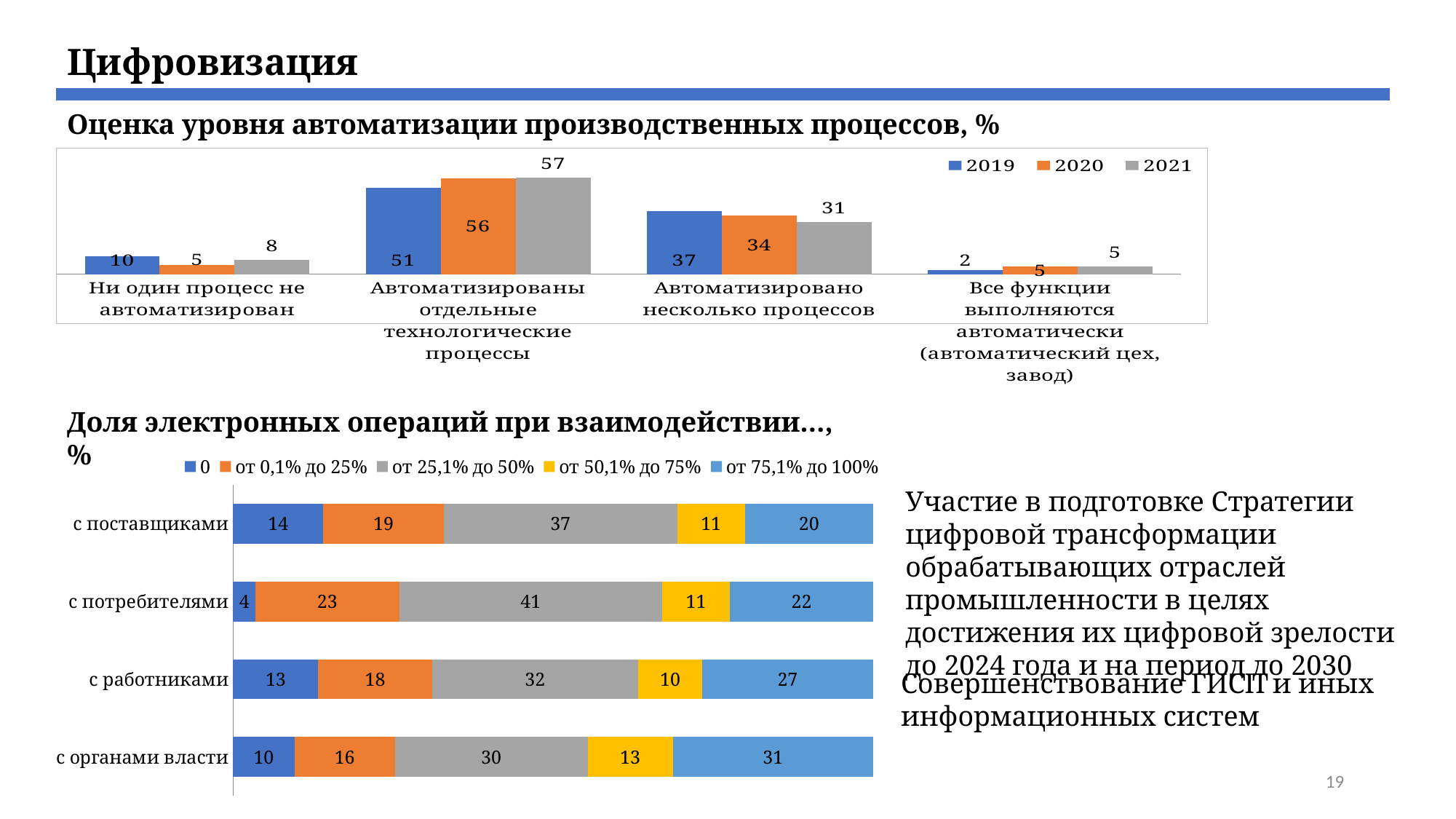
In the top chart 'Оценка уровня автоматизации производственных процессов, %', what is the difference between the 2019 and 2021 values for 'Автоматизировано несколько процессов'? 6 In the top chart 'Оценка уровня автоматизации производственных процессов, %', how many series does the legend list? 3 In the bottom chart 'Доля электронных операций при взаимодействии..., %', what is the value of the 'от 25,1% до 50%' segment for 'с потребителями'? 41 What type of chart is the bottom chart 'Доля электронных операций при взаимодействии..., %'? stacked bar chart In the top chart 'Оценка уровня автоматизации производственных процессов, %', which category has the lowest value in 2019? Все функции выполняются автоматически (автоматический цех, завод) In the top chart 'Оценка уровня автоматизации производственных процессов, %', what is the 2019 value for 'Автоматизировано несколько процессов'? 37 In the top chart 'Оценка уровня автоматизации производственных процессов, %', do the values for 'Автоматизировано несколько процессов' rise or fall from 2019 to 2021? fall In the top chart 'Оценка уровня автоматизации производственных процессов, %', which category has the highest value in 2020? Автоматизированы отдельные технологические процессы In the bottom chart 'Доля электронных операций при взаимодействии..., %', which is larger: the '0' segment for 'с поставщиками' or for 'с потребителями'? с поставщиками In the bottom chart 'Доля электронных операций при взаимодействии..., %', what is the total of the stacked bar for 'с работниками'? 100 In the top chart 'Оценка уровня автоматизации производственных процессов, %', what is the value for 'Автоматизированы отдельные технологические процессы' in 2021? 57 In the bottom chart 'Доля электронных операций при взаимодействии..., %', what is the value of the 'от 75,1% до 100%' segment for 'с органами власти'? 31